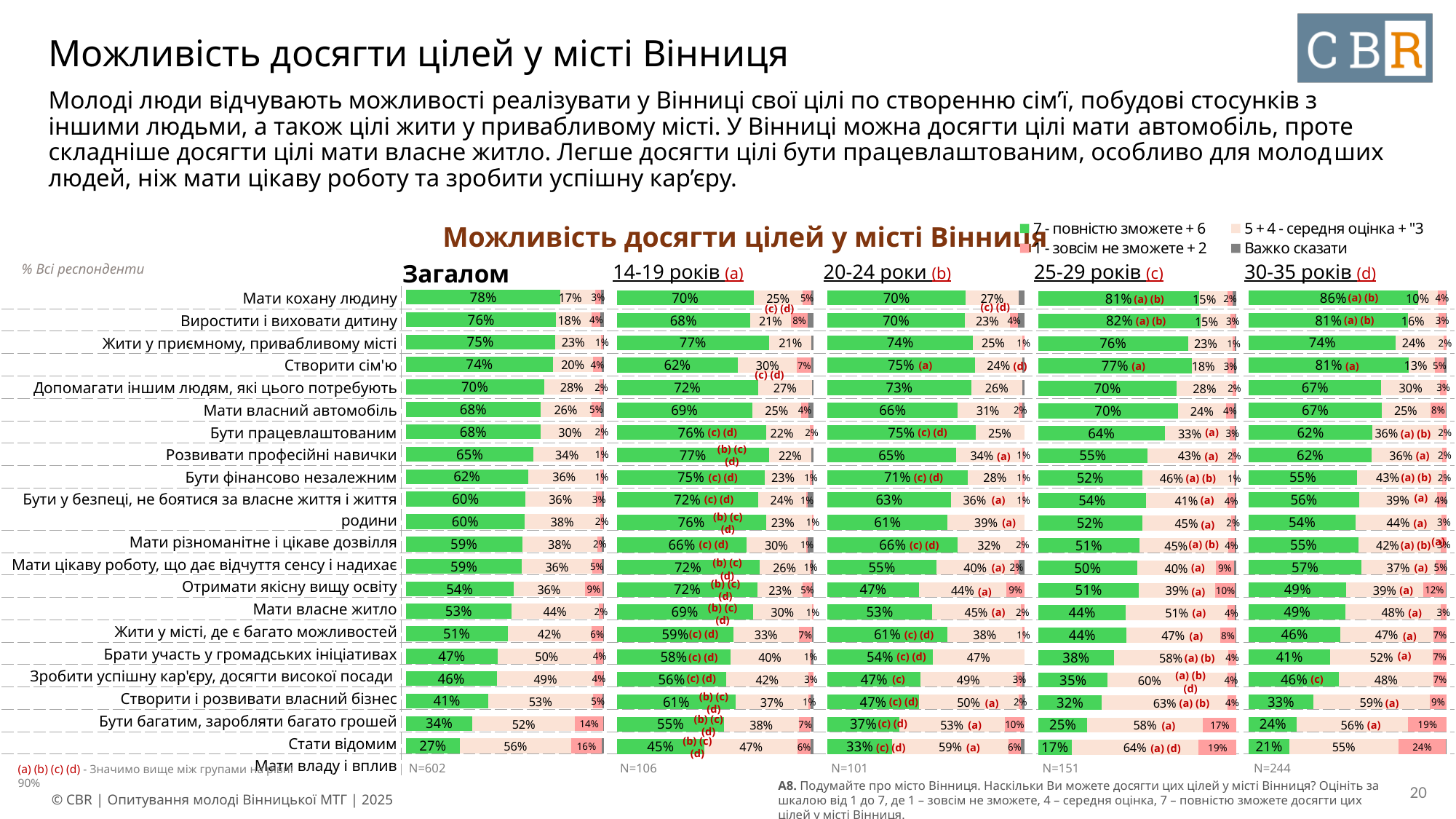
In the Загалом panel, what percentage is shown for the green (7 - повністю зможете + 6) segment of 'Мати кохану людину'? 78% In the 20-24 роки (b) panel, what is the green (7 + 6) percentage for 'Мати власний автомобіль'? 66% In the 30-35 років (d) panel, what is the green (7 + 6) percentage for 'Мати кохану людину'? 86% In the Загалом panel, which goal has the highest green (7 + 6) percentage? Мати кохану людину In the 25-29 років (c) panel, what is the green (7 + 6) percentage for 'Створити сім'ю'? 77% For 'Мати кохану людину', which age group has the larger green (7 + 6) percentage: 14-19 років (a) or 30-35 років (d)? 30-35 років (d) How many series does the chart legend list? 4 In the Загалом panel, what percentage is shown for the light (5 + 4 - середня оцінка + 3) segment of 'Бути фінансово незалежним'? 36% What is the sample size (N) shown for the 30-35 років (d) panel? N=244 In the Загалом panel, what is the difference between the green (7 + 6) percentages for 'Мати кохану людину' and 'Виростити і виховати дитину'? 2 percentage points For 'Бути працевлаштованим', which age group has the larger green (7 + 6) percentage: 14-19 років (a) or 25-29 років (c)? 14-19 років (a) What kind of chart is shown on the slide? Stacked bar chart